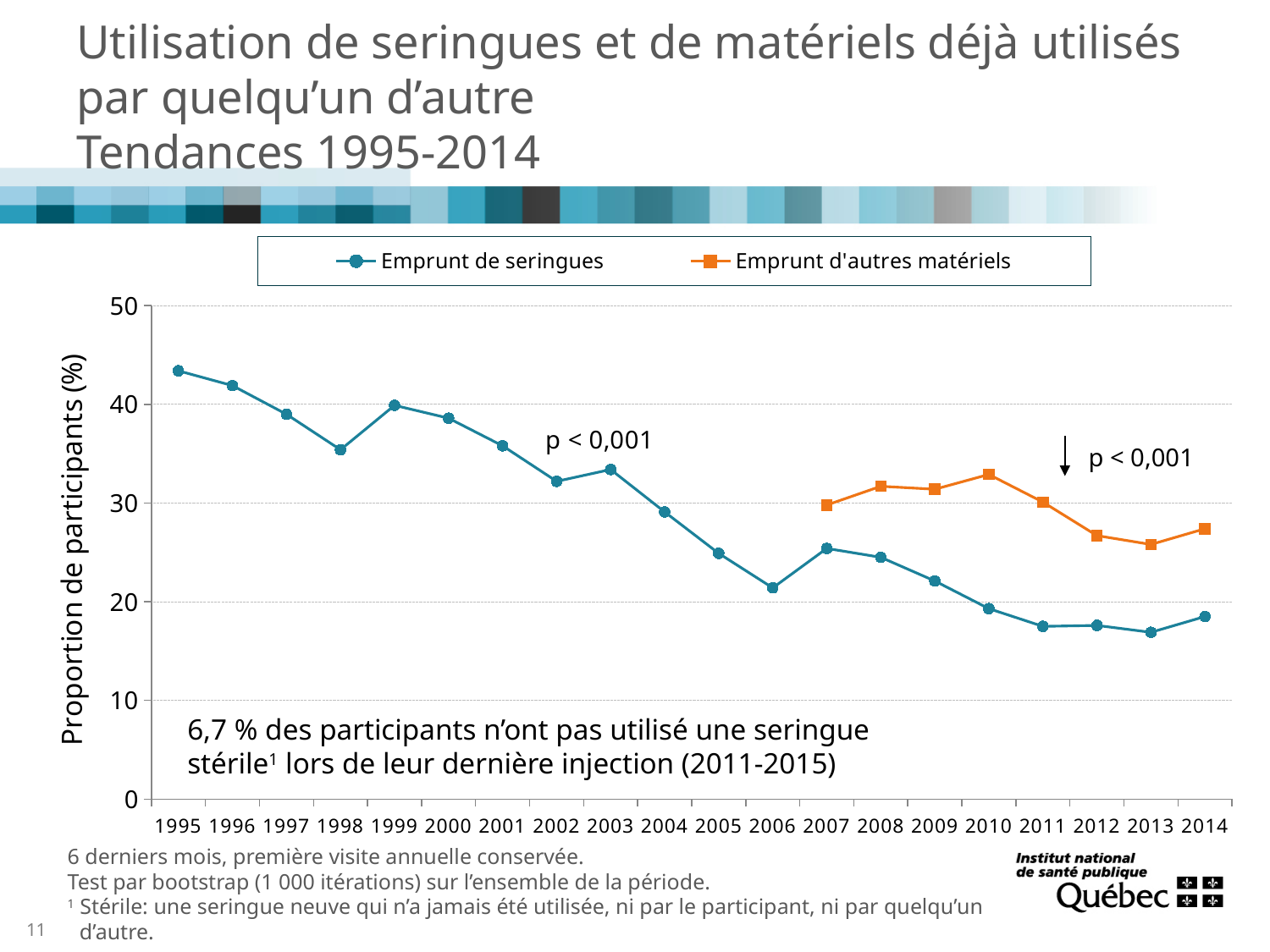
Is the 'Emprunt de seringues' value for 1995 greater or less than 40? greater In which year is the 'Emprunt d'autres matériels' value highest? 2010 How many data points does the 'Emprunt d'autres matériels' series have? 8 Overall, does the 'Emprunt de seringues' series rise or fall from 1995 to 2014? fall What is the label of the y axis? Proportion de participants (%) In 2010, which series has the larger value: 'Emprunt de seringues' or 'Emprunt d'autres matériels'? Emprunt d'autres matériels Is the 'Emprunt d'autres matériels' value for 2012 greater or less than 30? less What kind of chart is shown on the slide? line chart How many years are plotted on the x axis? 20 Is the 'Emprunt de seringues' value for 2013 greater or less than 20? less How many series does the legend list? 2 In which year is the 'Emprunt de seringues' value highest? 1995